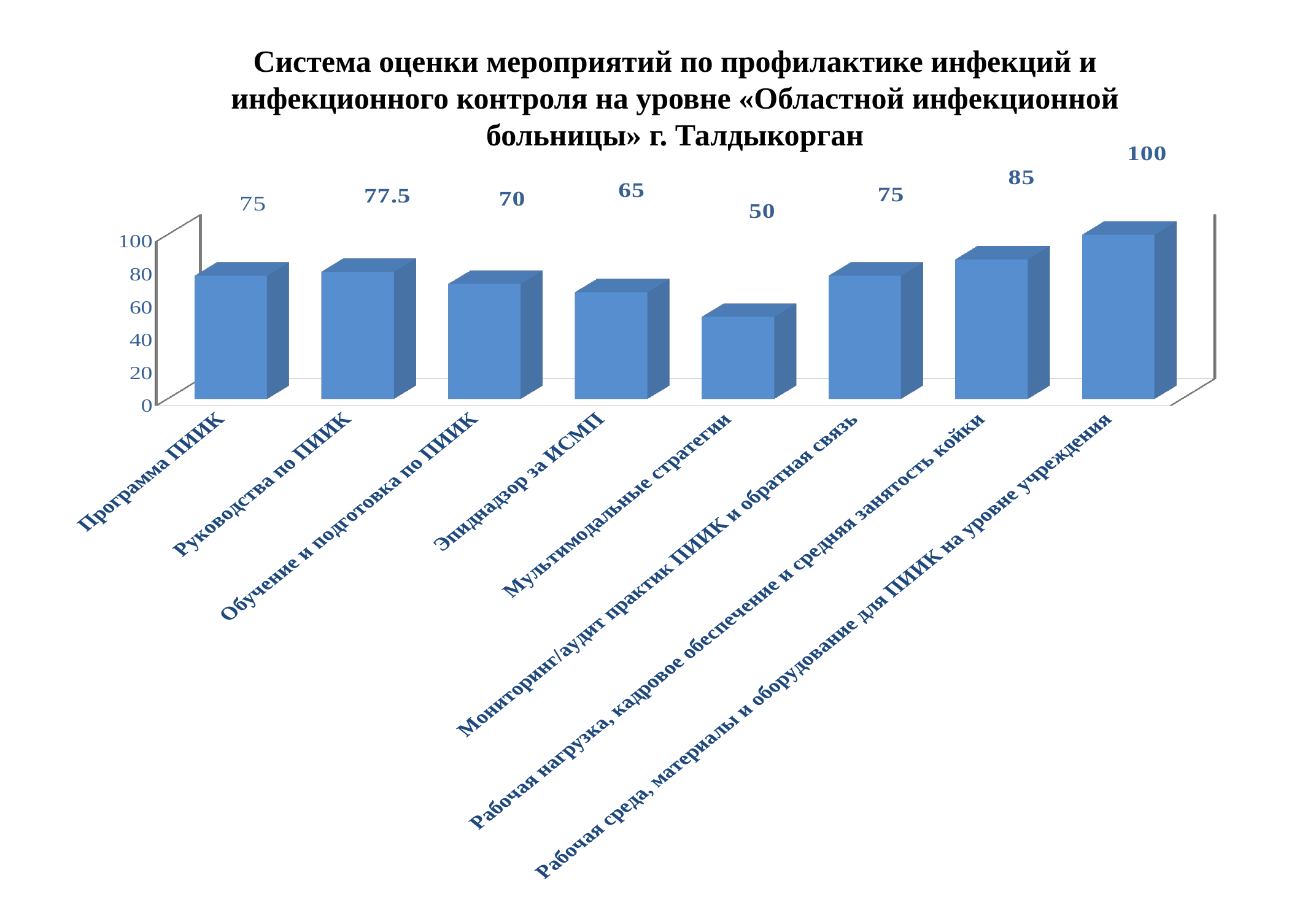
How many categories are shown in the chart? 8 What is the difference between the values for Руководства по ПИИК and Обучение и подготовка по ПИИК? 7.5 What is the value for Мониторинг/аудит практик ПИИК и обратная связь? 75 What is the value for Программа ПИИК? 75 What is the difference between the values for Эпиднадзор за ИСМП and Мультимодальные стратегии? 15 What is the value for Мультимодальные стратегии? 50 Which is larger: the value for Обучение и подготовка по ПИИК or the value for Рабочая нагрузка, кадровое обеспечение и средняя занятость койки? Рабочая нагрузка, кадровое обеспечение и средняя занятость койки What kind of chart is shown on the slide? Bar chart Which category has the lowest value? Мультимодальные стратегии Which category has the highest value? Рабочая среда, материалы и оборудование для ПИИК на уровне учреждения What is the value for Руководства по ПИИК? 77.5 What is the value for Рабочая нагрузка, кадровое обеспечение и средняя занятость койки? 85